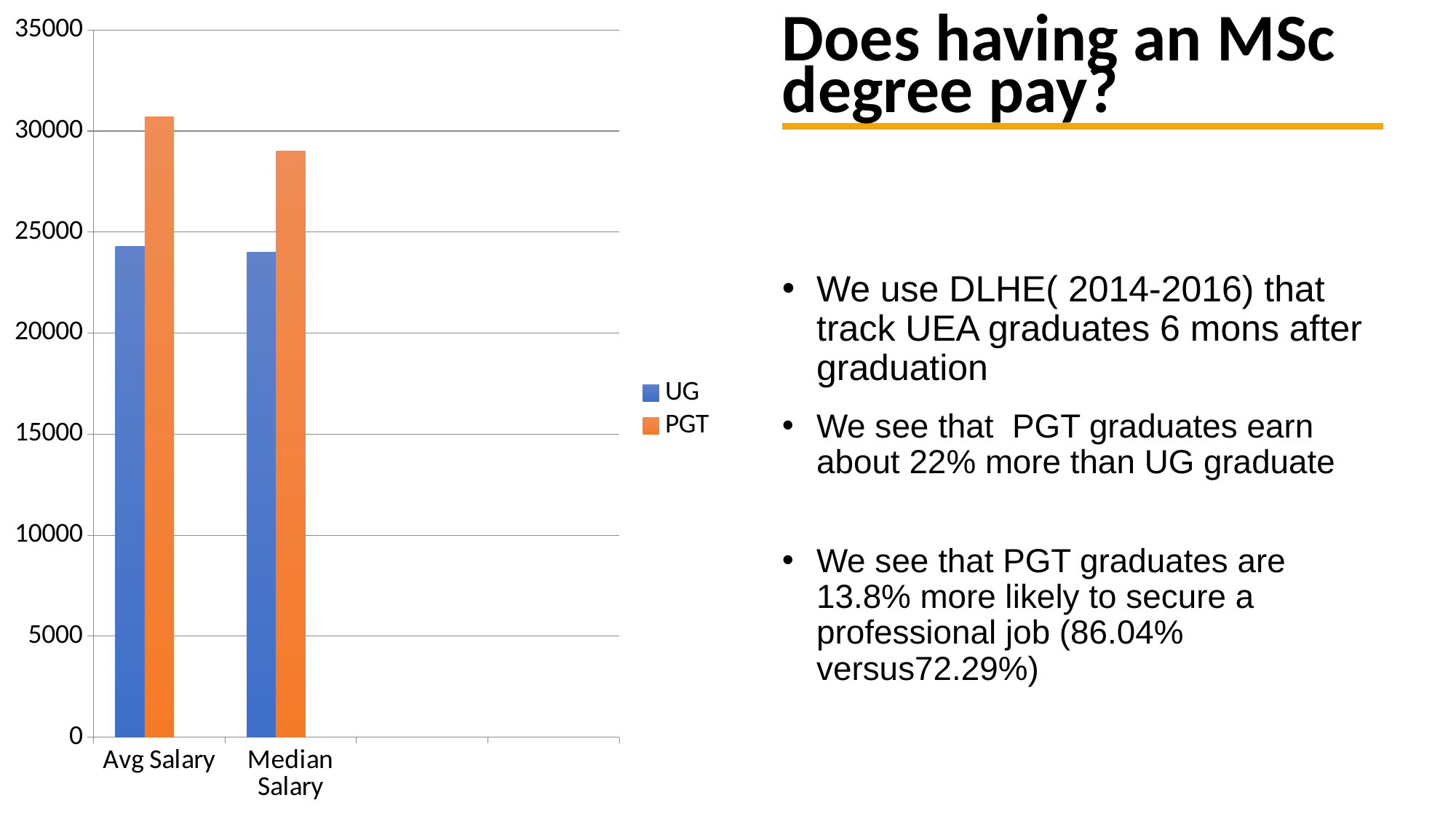
Is the UG value for Avg Salary greater or less than 25000? less Is the PGT value for Avg Salary greater or less than 25000? greater For the PGT series, which is larger, Avg Salary or Median Salary? Avg Salary Which bar in the chart is the tallest? PGT for Avg Salary For Median Salary, which series has the larger value, UG or PGT? PGT For Avg Salary, which series has the larger value, UG or PGT? PGT What kind of chart is shown on the slide? bar chart How many series does the chart legend list? 2 Which series is shown in orange in the chart? PGT Is the UG value for Median Salary greater or less than 20000? greater How many categories are shown on the x axis of the chart? 2